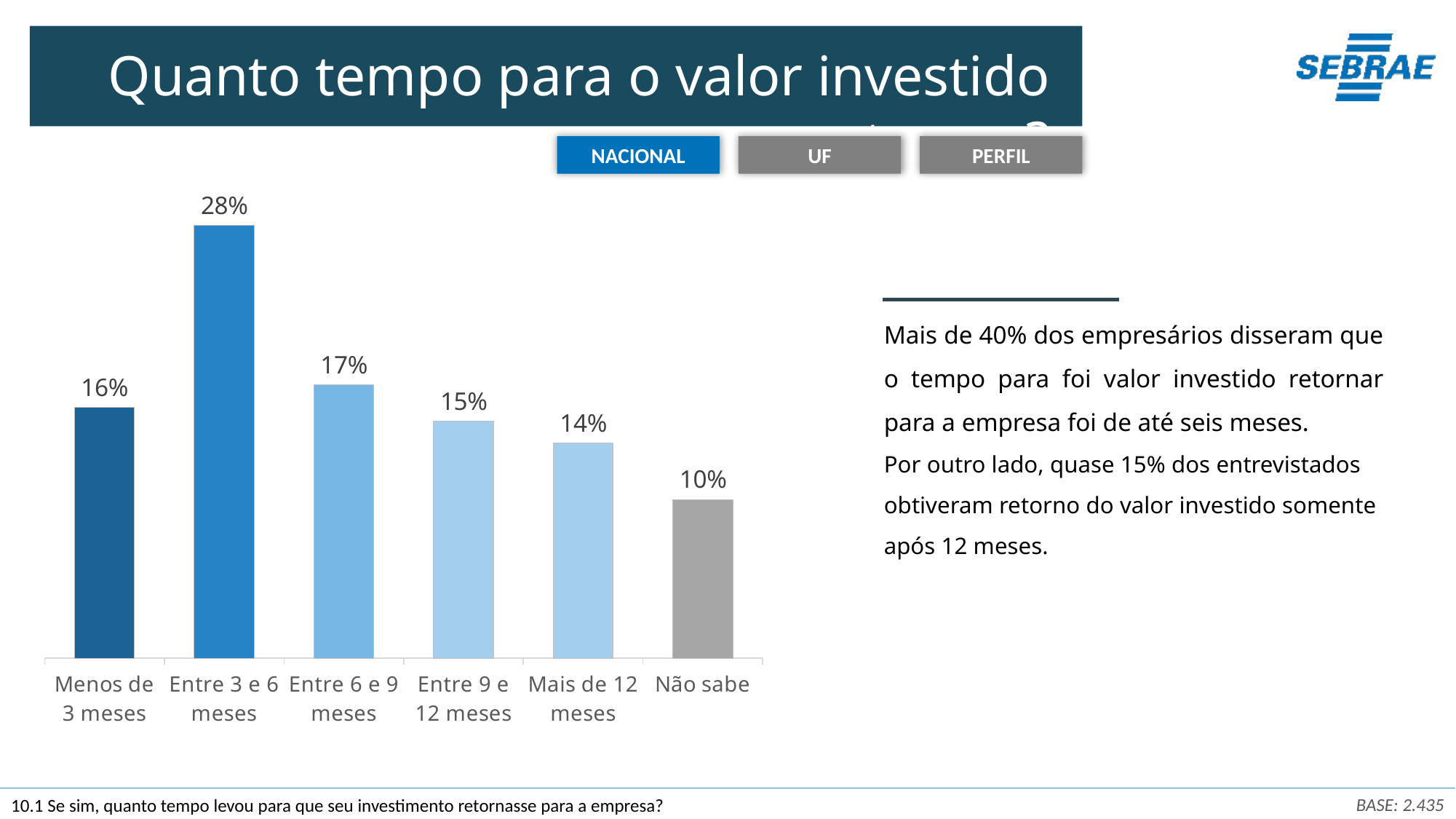
Which category has the lowest value? Não sabe What colour is the bar for "Não sabe"? Grey Which is larger, the value for "Entre 9 e 12 meses" or the value for "Mais de 12 meses"? Entre 9 e 12 meses What is the value for "Entre 3 e 6 meses"? 28% Which category has the highest value? Entre 3 e 6 meses What is the value for "Não sabe"? 10% How many categories are shown in the chart? 6 What kind of chart is shown on the slide? Bar chart What is the difference between the values for "Menos de 3 meses" and "Não sabe"? 6% What is the value for "Menos de 3 meses"? 16% What is the difference between the values for "Entre 3 e 6 meses" and "Entre 6 e 9 meses"? 11% What is the value for "Mais de 12 meses"? 14%